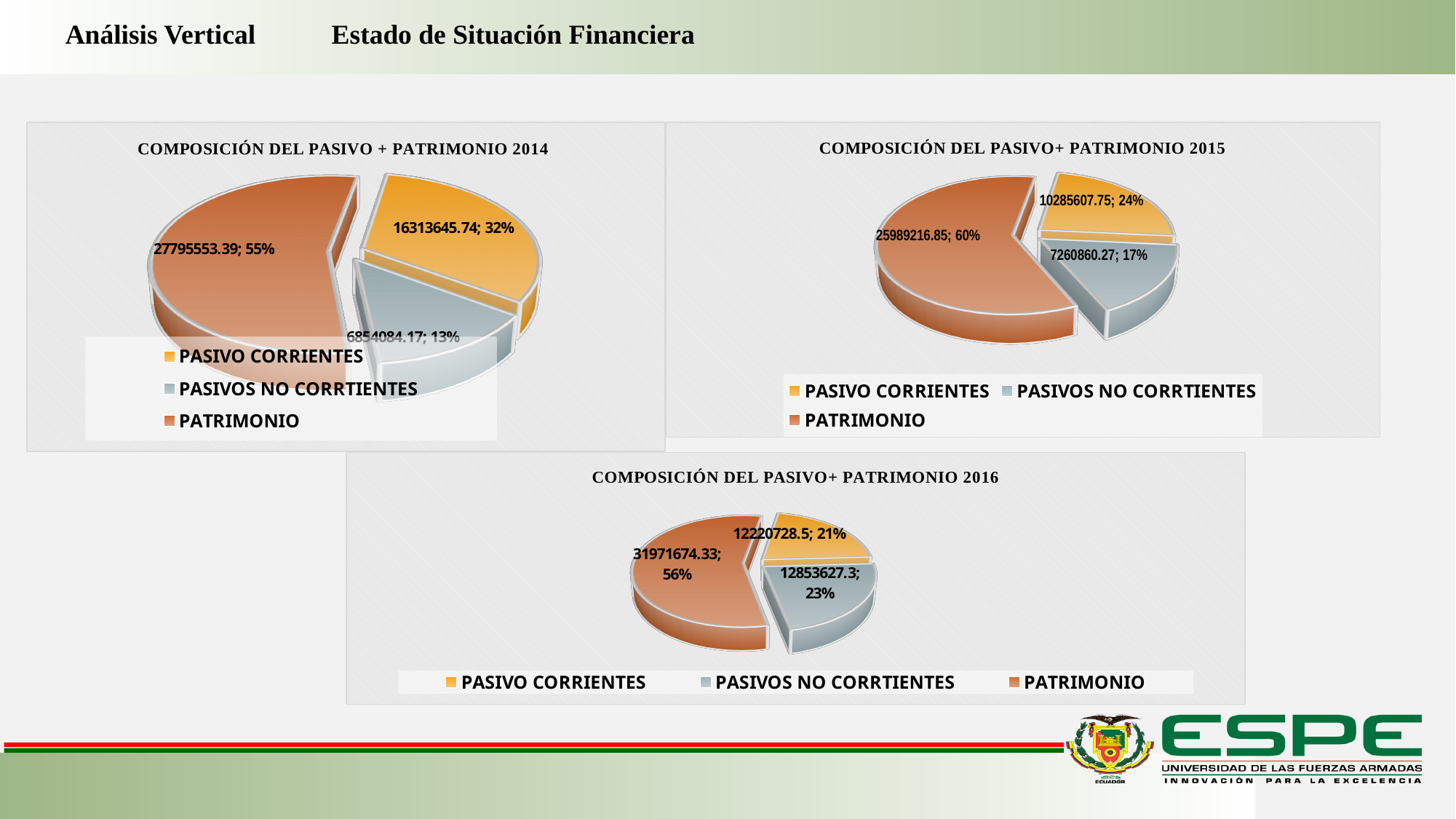
In the 2015 chart, which category has the largest slice? PATRIMONIO In the 2016 chart, what share of the pie is PASIVOS NO CORRTIENTES? 23% In the 2015 chart, what share of the pie is PASIVO CORRIENTES? 24% In the 2016 chart, what is the difference in percentage points between PATRIMONIO and PASIVO CORRIENTES? 35 percentage points What type of chart is used for COMPOSICIÓN DEL PASIVO + PATRIMONIO 2014? Pie chart In the 2016 chart (COMPOSICIÓN DEL PASIVO+ PATRIMONIO 2016), what is the value shown for PATRIMONIO? 31971674.33 In the 2014 chart (COMPOSICIÓN DEL PASIVO + PATRIMONIO 2014), what share of the pie is PATRIMONIO? 55% In the 2016 chart, which is larger, PASIVO CORRIENTES or PASIVOS NO CORRTIENTES? PASIVOS NO CORRTIENTES How many slices does the 2015 chart have? 3 In the 2015 chart (COMPOSICIÓN DEL PASIVO+ PATRIMONIO 2015), what is the value shown for PASIVOS NO CORRTIENTES? 7260860.27 In the 2014 chart, what is the value shown for PASIVO CORRIENTES? 16313645.74 In the 2014 chart, which category has the smallest slice? PASIVOS NO CORRTIENTES